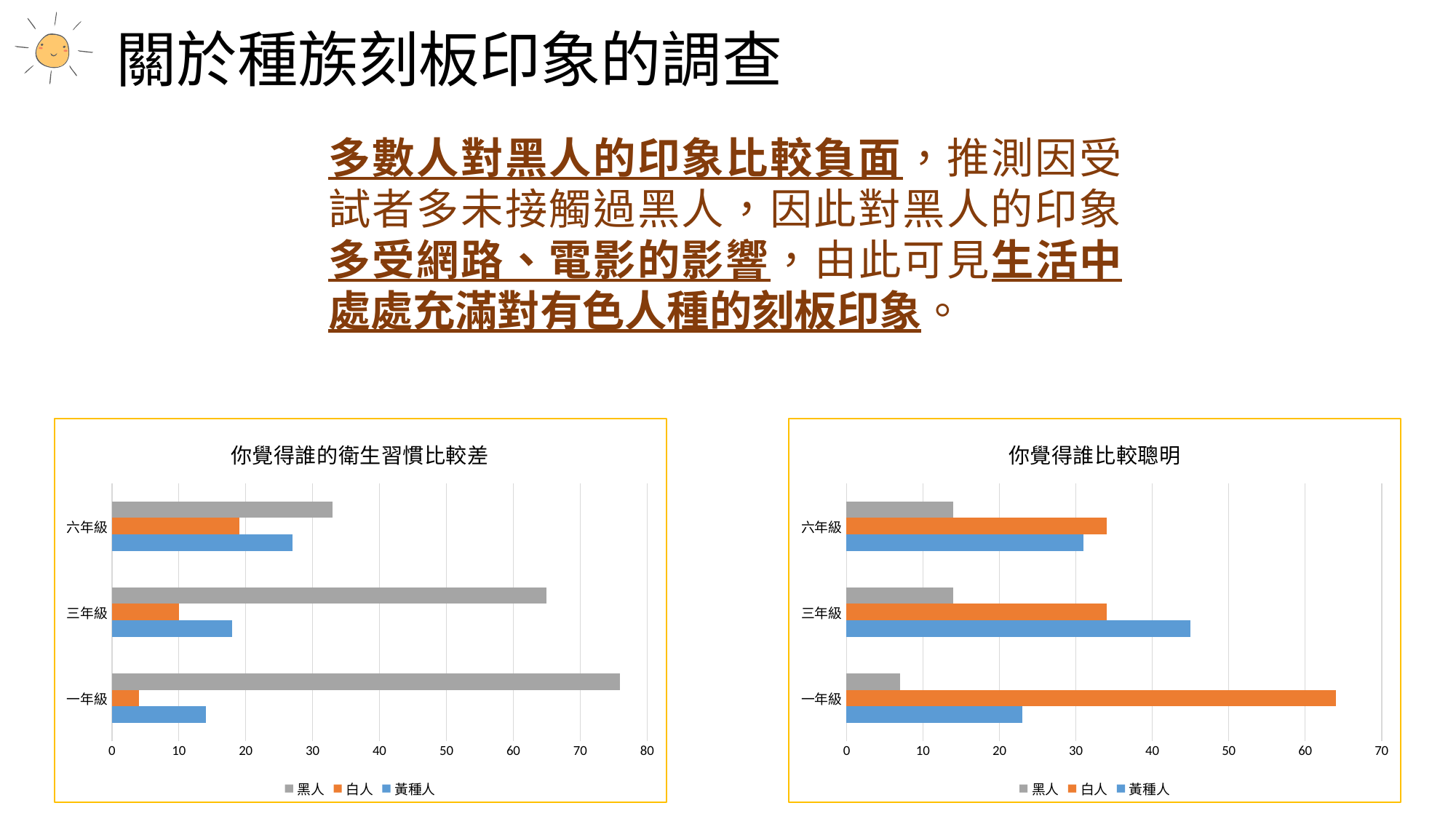
In the chart titled 你覺得誰的衛生習慣比較差, is the value for 黑人 in 三年級 greater or less than 60? greater In the chart titled 你覺得誰比較聰明, which series has the highest value for 一年級? 白人 In the chart titled 你覺得誰比較聰明, which series has the lowest value for 三年級? 黑人 What kind of chart is the chart titled 你覺得誰的衛生習慣比較差? bar chart In the chart titled 你覺得誰比較聰明, which is larger for 三年級: 黃種人 or 白人? 黃種人 In the chart titled 你覺得誰比較聰明, is the value for 白人 in 一年級 greater or less than 60? greater How many grade categories are shown on the y axis of the chart titled 你覺得誰的衛生習慣比較差? 3 How many series does the legend list in the chart titled 你覺得誰比較聰明? 3 In the chart titled 你覺得誰的衛生習慣比較差, which series has the lowest value for 一年級? 白人 What is the title of the chart on the right side of the slide? 你覺得誰比較聰明 In the chart titled 你覺得誰的衛生習慣比較差, which series has the highest value for 一年級? 黑人